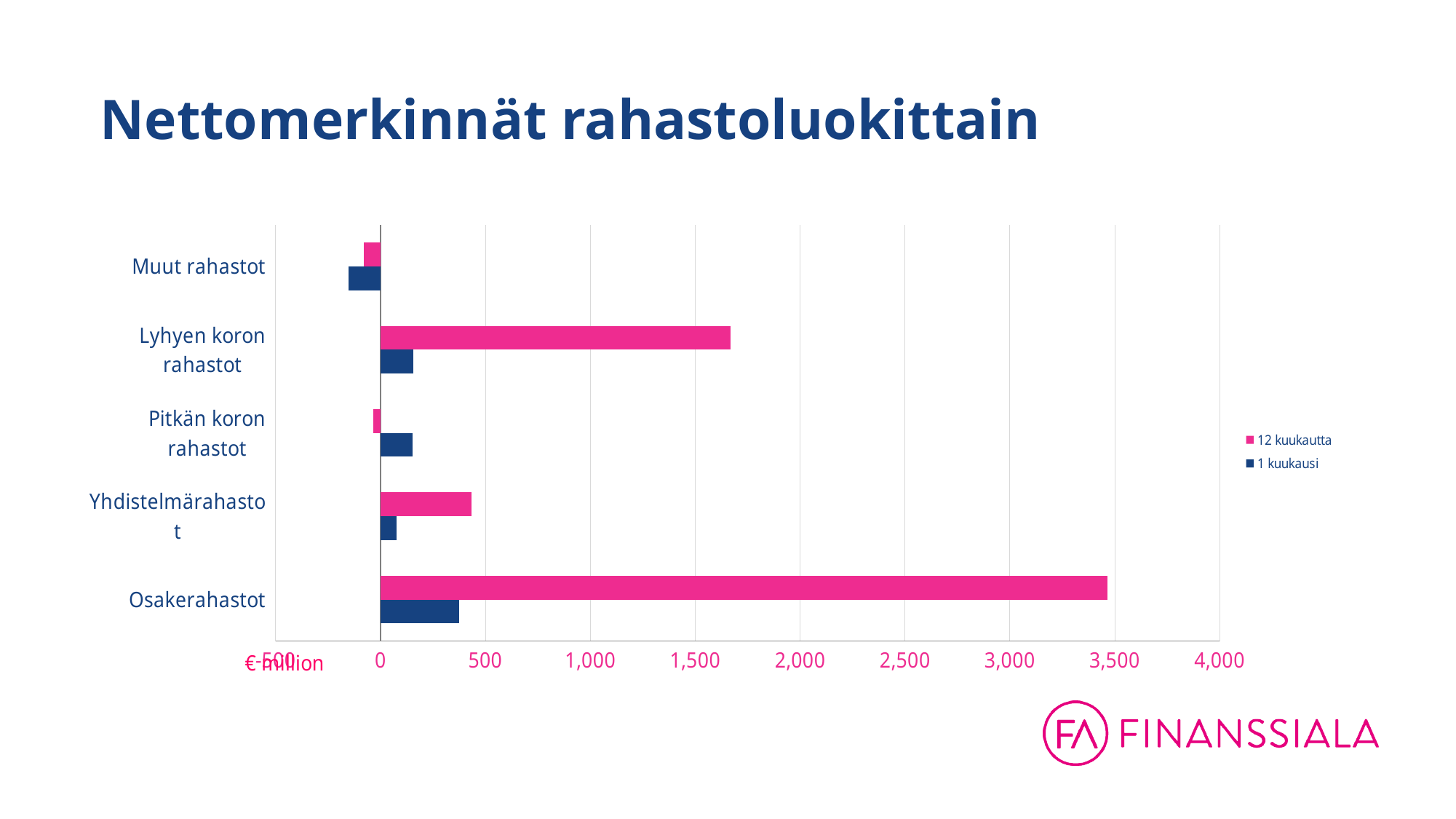
Which category has the highest value for the 1 kuukausi series? Osakerahastot Is the 12 kuukautta value for Lyhyen koron rahastot greater or less than 1,500? greater What is the title of the chart on the slide? Nettomerkinnät rahastoluokittain Is the 12 kuukautta value for Osakerahastot greater or less than 3,000? greater What kind of chart is shown on the slide? bar chart Which category has the lowest value for the 1 kuukausi series? Muut rahastot Which is larger for the 12 kuukautta series: Lyhyen koron rahastot or Yhdistelmärahastot? Lyhyen koron rahastot Which category has the lowest value for the 12 kuukautta series? Muut rahastot Is the 1 kuukausi value for Osakerahastot greater or less than 500? less Which category has the highest value for the 12 kuukautta series? Osakerahastot How many series does the legend list? 2 How many fund categories are shown on the chart? 5